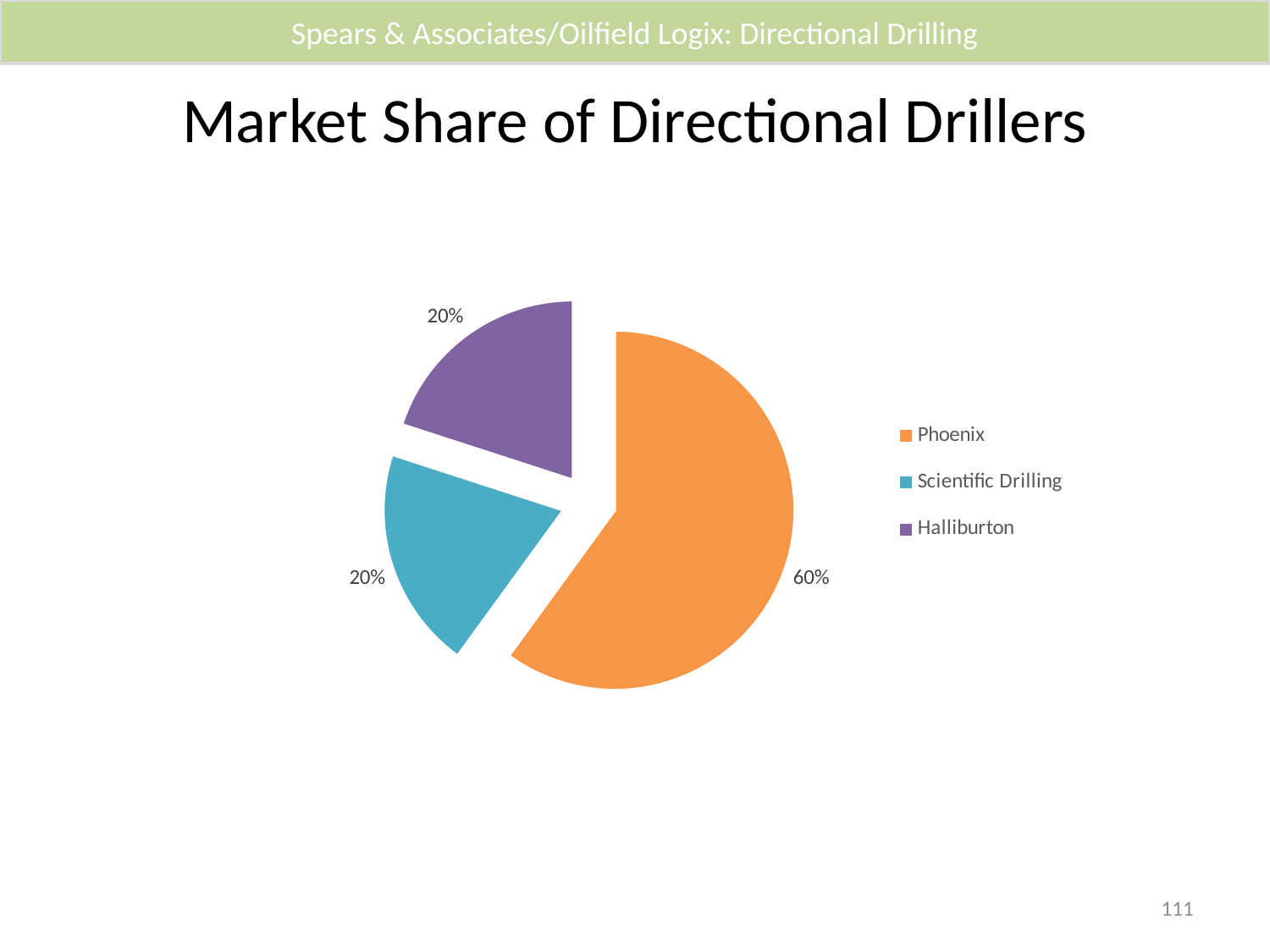
What share of the pie does Phoenix hold? 60% Which is larger, the share for Phoenix or the share for Scientific Drilling? Phoenix What colour is the Halliburton slice? purple Which company has the largest market share? Phoenix What share of the pie does Halliburton hold? 20% What share of the pie does Scientific Drilling hold? 20% How many slices does the pie chart have? 3 What is the title of the chart? Market Share of Directional Drillers What is the difference between Phoenix's share and Halliburton's share? 40% How many entries does the legend list? 3 What kind of chart is shown on the slide? pie chart What is the combined share of Scientific Drilling and Halliburton? 40%